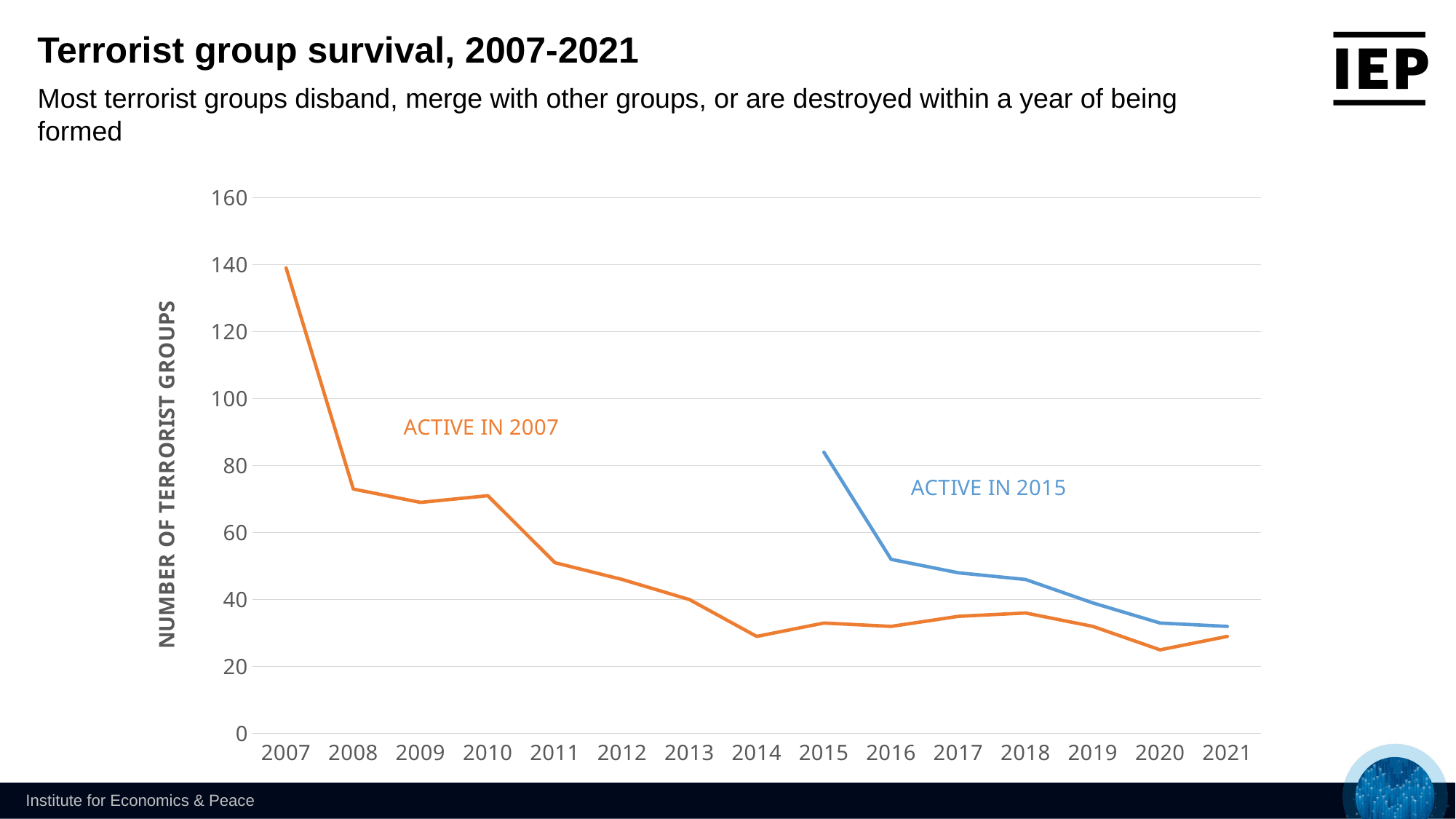
In which year does the ACTIVE IN 2015 series reach its highest value? 2015 In 2016, which series has the larger value, ACTIVE IN 2007 or ACTIVE IN 2015? ACTIVE IN 2015 Is the value for ACTIVE IN 2007 in 2014 greater or less than 40? less Does the ACTIVE IN 2007 line generally rise or fall from 2007 to 2021? fall Does the ACTIVE IN 2015 line rise or fall from 2015 to 2021? fall What is the title of the chart? Terrorist group survival, 2007-2021 How many years are shown along the x axis? 15 In which year does the ACTIVE IN 2007 series reach its highest value? 2007 What kind of chart is shown on the slide? line chart Is the value for ACTIVE IN 2007 in 2007 greater or less than 120? greater How many series are plotted on the chart? 2 What is the label on the y axis? NUMBER OF TERRORIST GROUPS